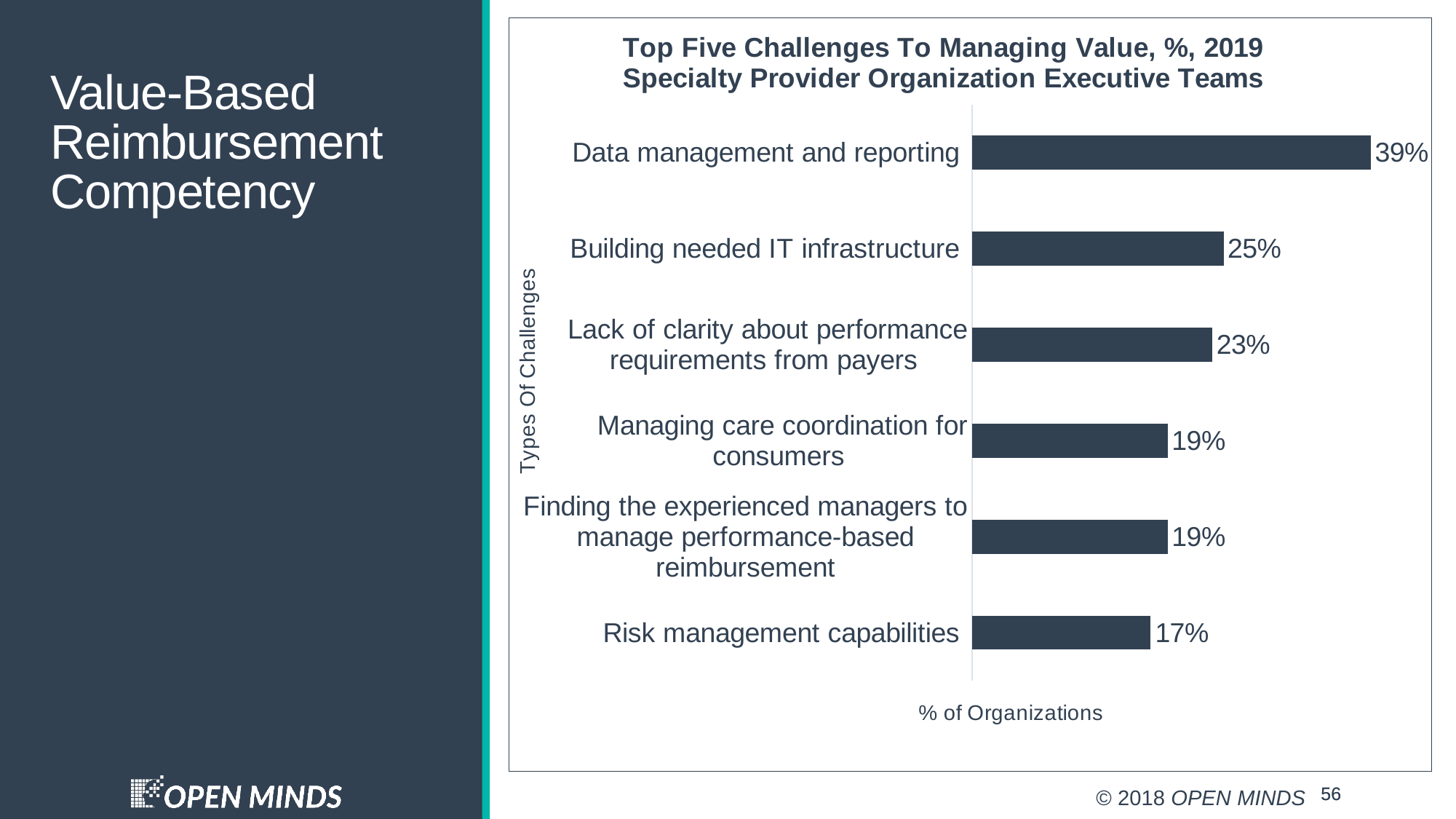
Which challenge has the highest percentage of organizations? Data management and reporting What is the difference in percentage points between Data management and reporting and Building needed IT infrastructure? 14 What is the value for Lack of clarity about performance requirements from payers? 23% What percentage of organizations cited Data management and reporting as a challenge? 39% What is the value for Risk management capabilities? 17% How many challenges are plotted in the chart? 6 What is the title of the chart? Top Five Challenges To Managing Value, %, 2019 Specialty Provider Organization Executive Teams What kind of chart is shown on the slide? Bar chart What is the value for Building needed IT infrastructure? 25% Which challenge has the lowest percentage of organizations? Risk management capabilities What is the label of the horizontal axis of the chart? % of Organizations Which is larger: the value for Building needed IT infrastructure or the value for Managing care coordination for consumers? Building needed IT infrastructure